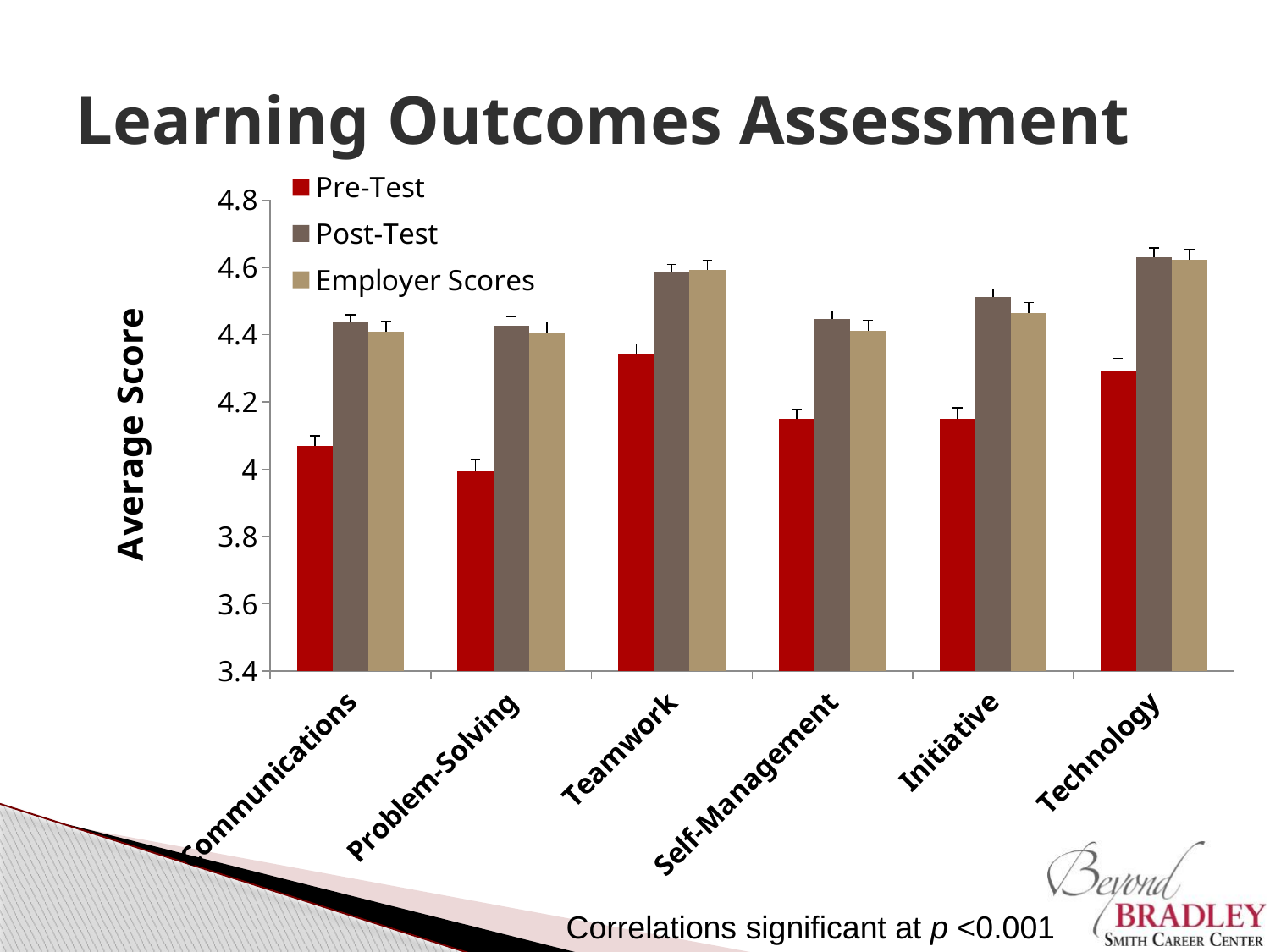
How many series does the legend list? 3 Is the Pre-Test value for Technology greater or less than 4.2? greater Is the Post-Test value for Technology greater or less than 4.6? greater Is the Pre-Test value for Teamwork greater or less than 4.2? greater How many categories are shown on the x axis? 6 What kind of chart is shown on the slide? bar chart For Initiative, which is larger: the Pre-Test score or the Post-Test score? Post-Test What is the title of the y axis? Average Score Which category has the lowest Pre-Test score? Problem-Solving Which is larger: the Post-Test score for Technology or the Post-Test score for Communications? Technology